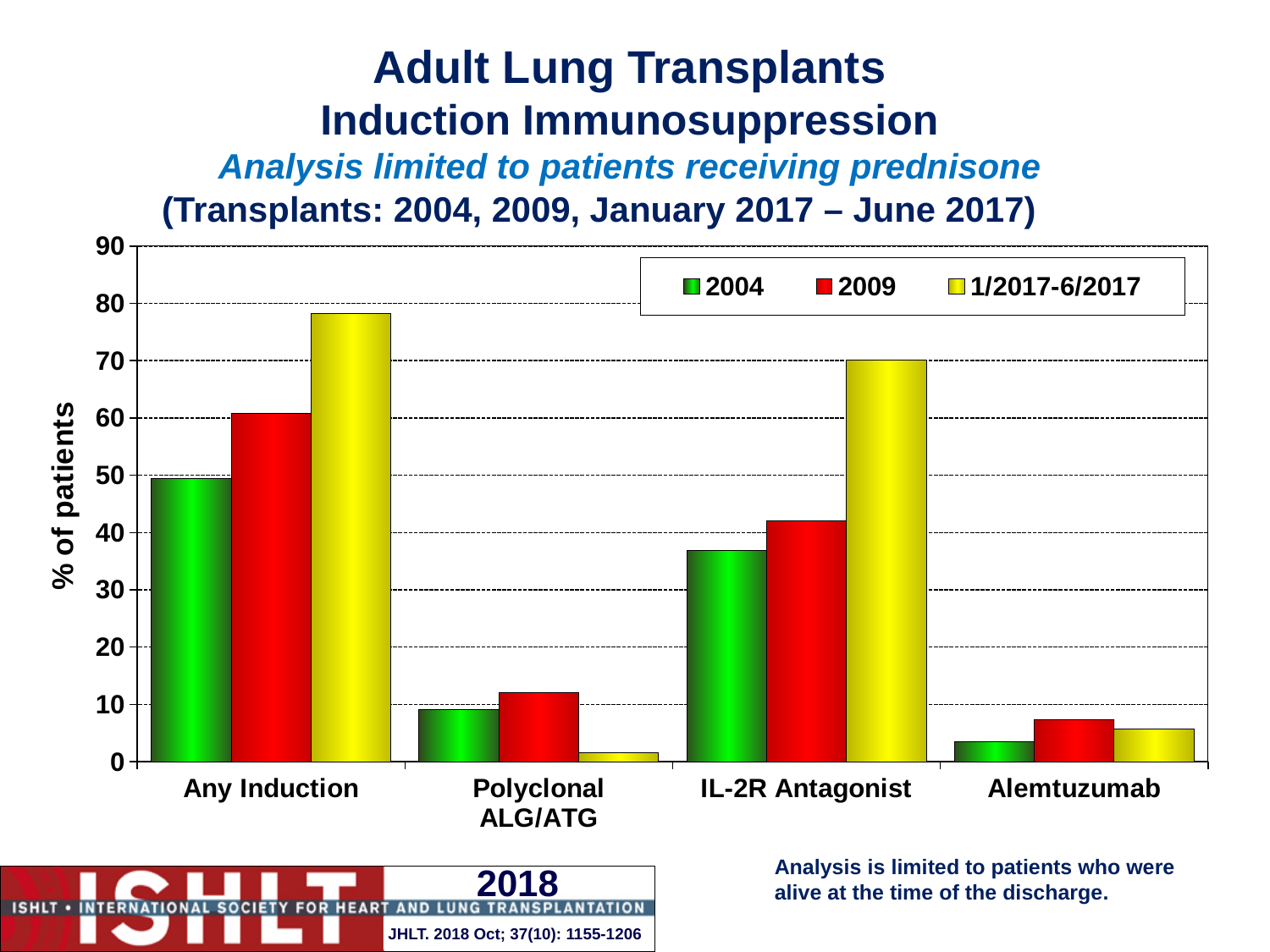
What is the label of the vertical axis? % of patients For IL-2R Antagonist, do the values rise or fall from 2004 to 2009 to 1/2017-6/2017? rise For IL-2R Antagonist, which is larger: the 2009 value or the 1/2017-6/2017 value? 1/2017-6/2017 Is the value for Any Induction in 1/2017-6/2017 greater or less than 70? greater Is the value for Alemtuzumab in 2004 greater or less than 10? less Is the value for Polyclonal ALG/ATG in 1/2017-6/2017 greater or less than 10? less Which category and series has the shortest bar in the chart? Polyclonal ALG/ATG, 1/2017-6/2017 How many categories are shown on the x axis of the chart? 4 How many series does the chart's legend list? 3 What kind of chart is shown on the slide? bar chart Which category and series has the tallest bar in the chart? Any Induction, 1/2017-6/2017